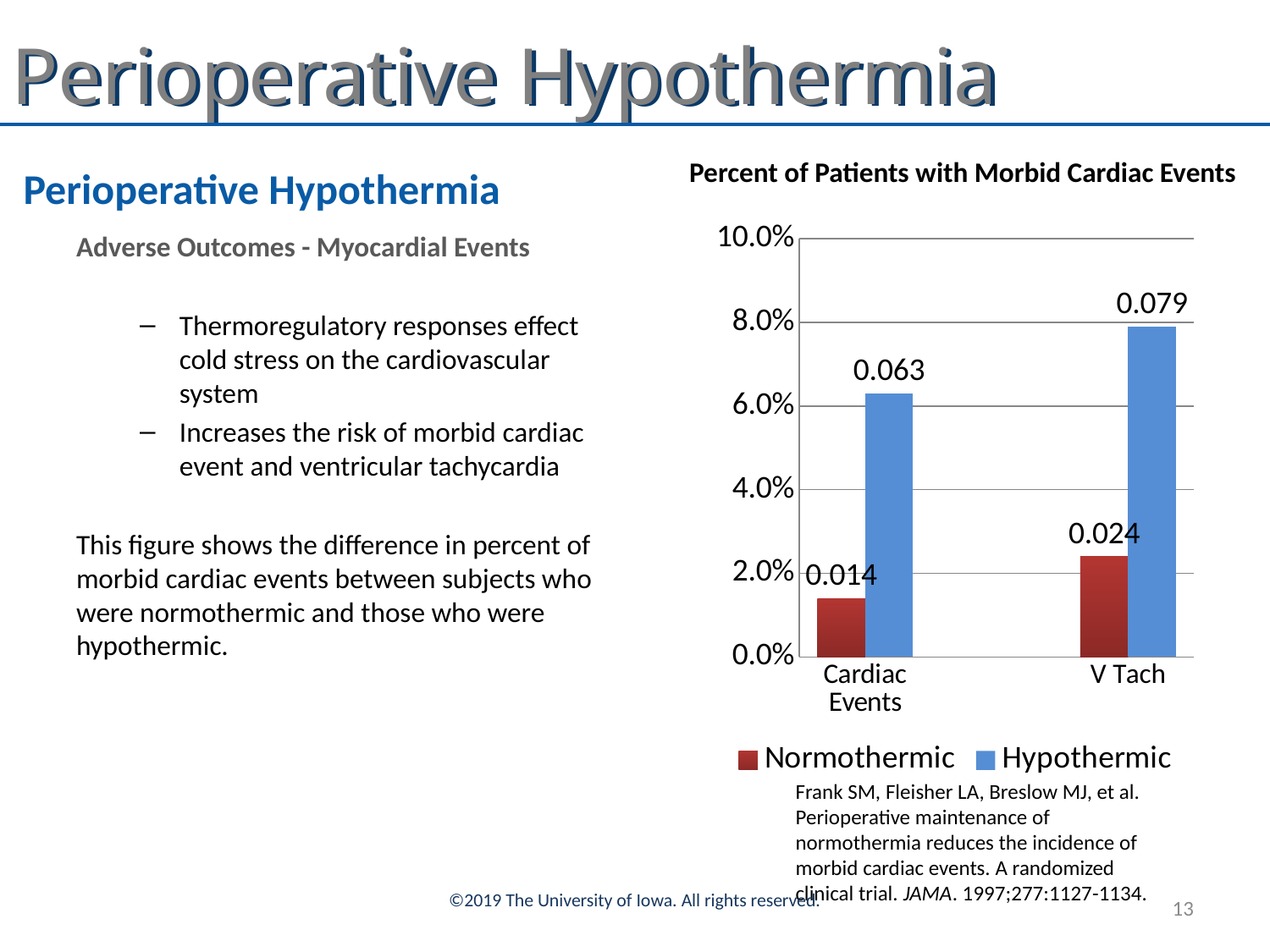
What is the value for Hypothermic in the Cardiac Events category? 0.063 What kind of chart is shown on the slide? Bar chart What is the difference between the Hypothermic and Normothermic values for V Tach? 0.055 Which bar has the highest value on the chart? Hypothermic, V Tach What is the value for Normothermic in the Cardiac Events category? 0.014 What is the value for Hypothermic in the V Tach category? 0.079 How many categories are shown on the x axis? 2 Which is larger, the Hypothermic value for Cardiac Events or the Hypothermic value for V Tach? Hypothermic value for V Tach What is the difference between the Hypothermic and Normothermic values for Cardiac Events? 0.049 Which bar has the lowest value on the chart? Normothermic, Cardiac Events How many series does the legend list? 2 What is the value for Normothermic in the V Tach category? 0.024